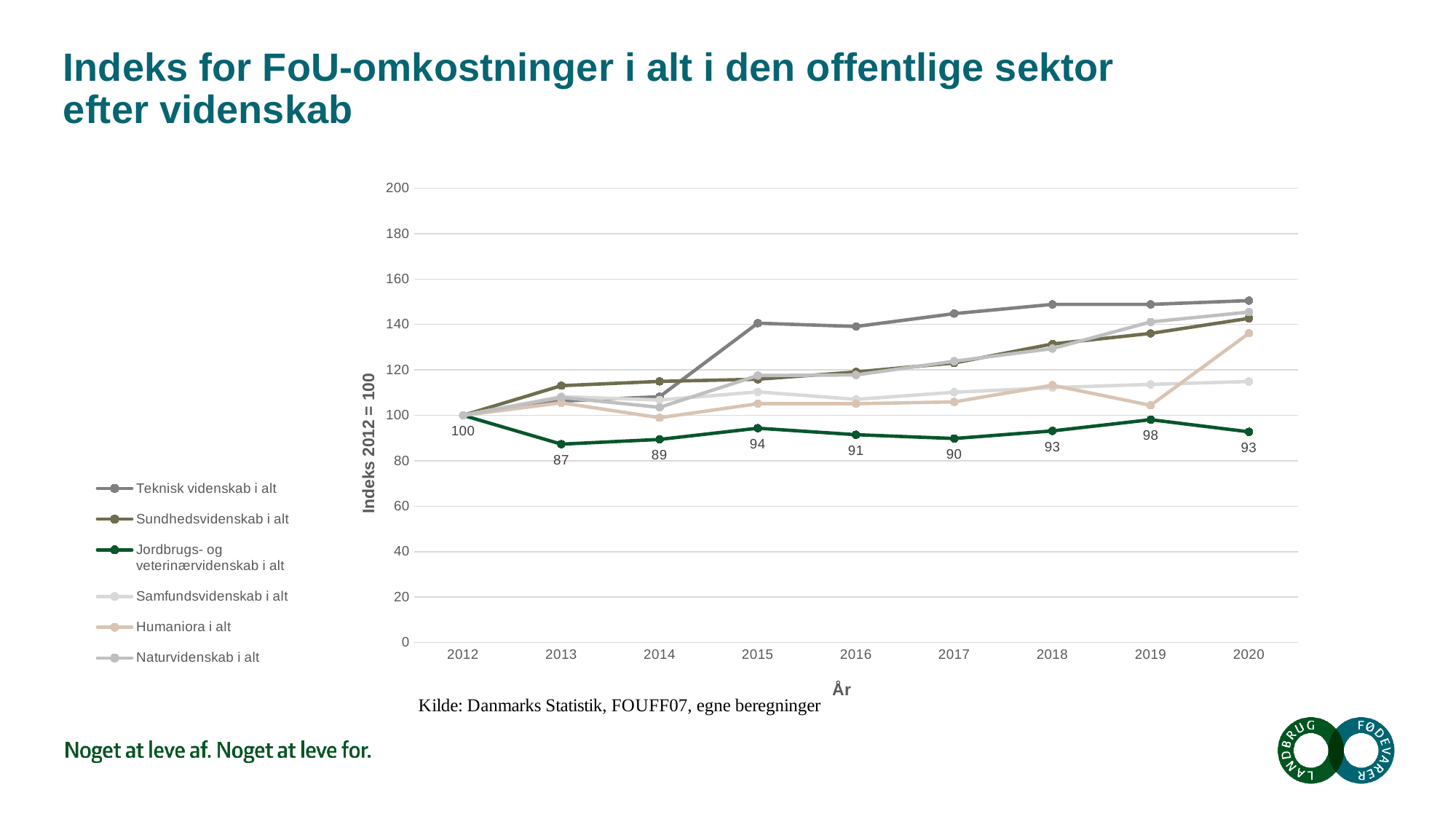
What is the value for Jordbrugs- og veterinærvidenskab i alt in 2013? 87 Is the value for Teknisk videnskab i alt in 2020 greater or less than 140? greater What kind of chart is shown on the slide? line chart Which series has the lowest value in 2020? Jordbrugs- og veterinærvidenskab i alt In which year is the value for Jordbrugs- og veterinærvidenskab i alt lowest? 2013 How many years are shown on the x axis? 9 How many series does the legend list? 6 What is the value for Jordbrugs- og veterinærvidenskab i alt in 2020? 93 For Jordbrugs- og veterinærvidenskab i alt, which is larger: the value in 2015 or in 2016? 2015 What is the value for Jordbrugs- og veterinærvidenskab i alt in 2019? 98 Is the value for Humaniora i alt in 2019 greater or less than 120? less What is the difference between the 2019 and 2013 values for Jordbrugs- og veterinærvidenskab i alt? 11